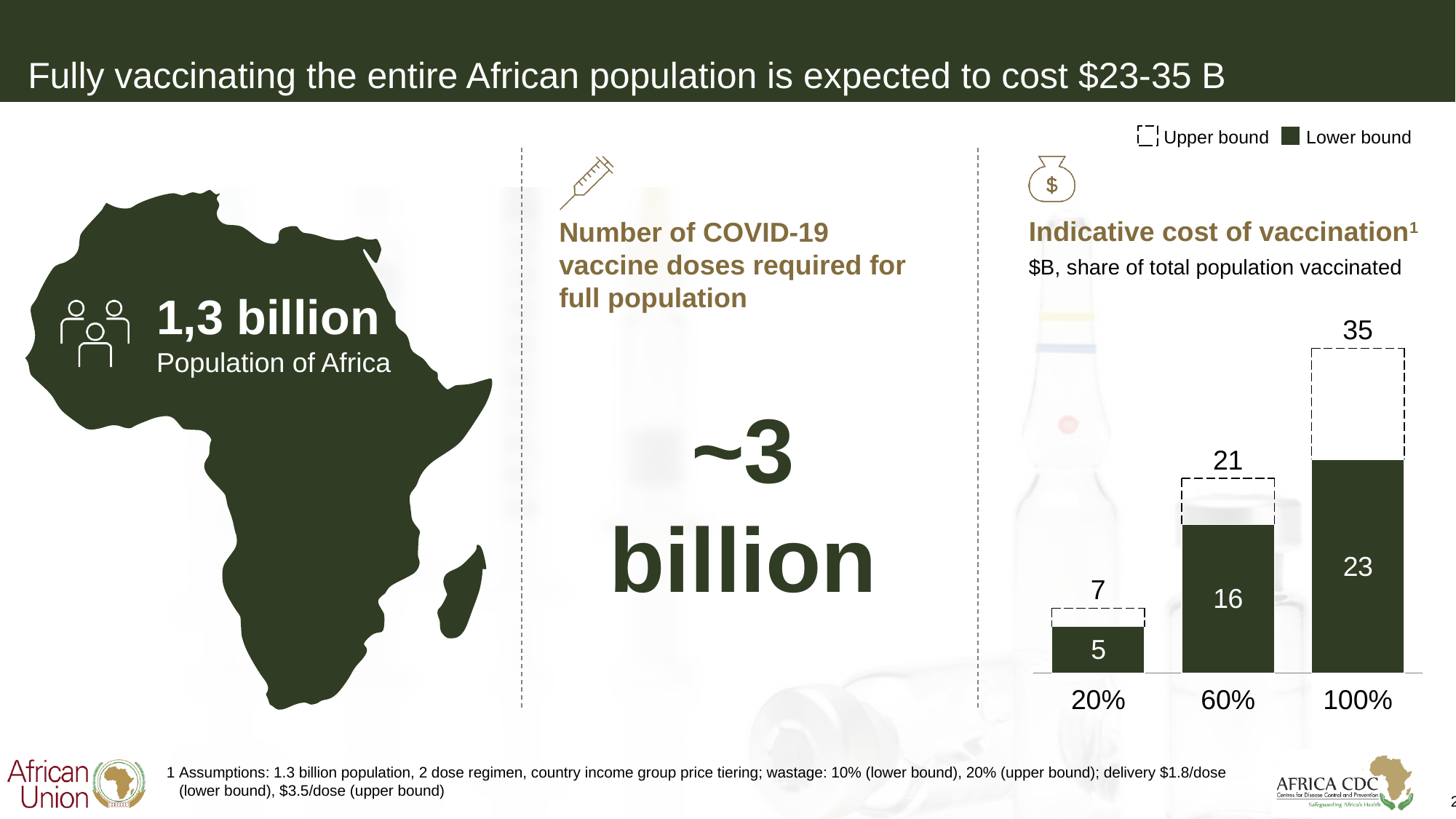
What is the difference between the upper bound and lower bound cost at 100% of the population vaccinated? 12 How many series does the legend of the cost chart list? 2 What is the lower bound cost for vaccinating 60% of the population? 16 What is the lower bound cost for vaccinating 20% of the population? 5 Which share of population vaccinated has the highest lower bound cost? 100% What is the upper bound cost for vaccinating 20% of the population? 7 What is the difference between the lower bound costs at 60% and 20% of the population vaccinated? 11 How many population share categories are shown on the cost chart? 3 What is the upper bound cost for vaccinating 100% of the population? 35 What kind of chart is used to show the indicative cost of vaccination? Bar chart Which is larger: the upper bound cost at 60% or the lower bound cost at 100%? Lower bound cost at 100% Which share of population vaccinated has the lowest upper bound cost? 20%